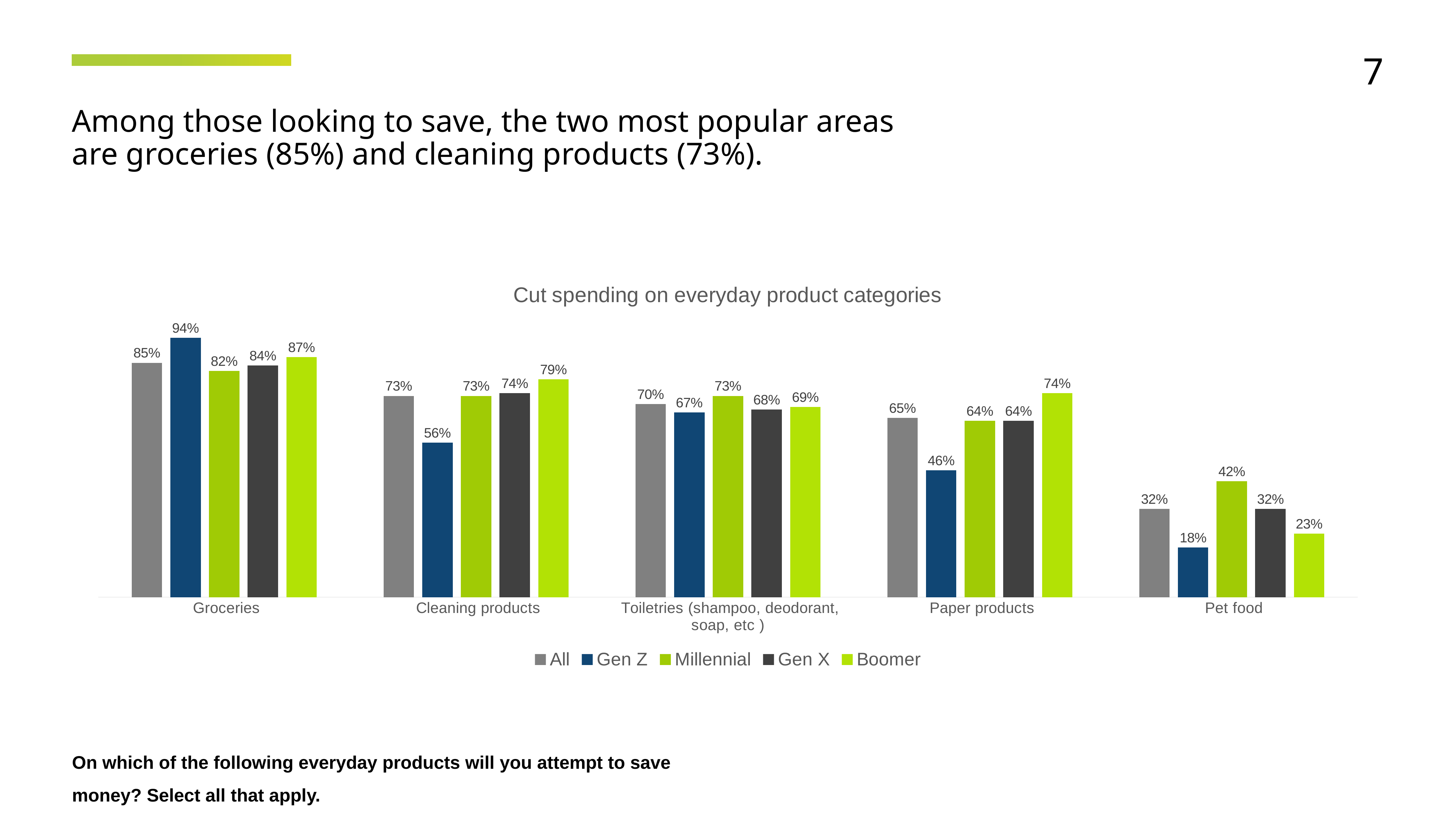
How many series does the legend list? 5 Which is larger for Toiletries: the Gen Z value or the Millennial value? Millennial Which category has the highest value for the All series? Groceries What is the value for Gen Z in the Groceries category? 94% What kind of chart is shown on the slide? Bar chart Which category has the lowest value for the Gen Z series? Pet food What is the value for Millennial in the Pet food category? 42% What is the value for Boomer in the Cleaning products category? 79% What is the difference between the Gen Z and Boomer values for Paper products? 28% What is the title of the chart? Cut spending on everyday product categories Do the values for the All series rise or fall from Groceries to Pet food along the x axis? Fall How many product categories are shown on the x axis? 5